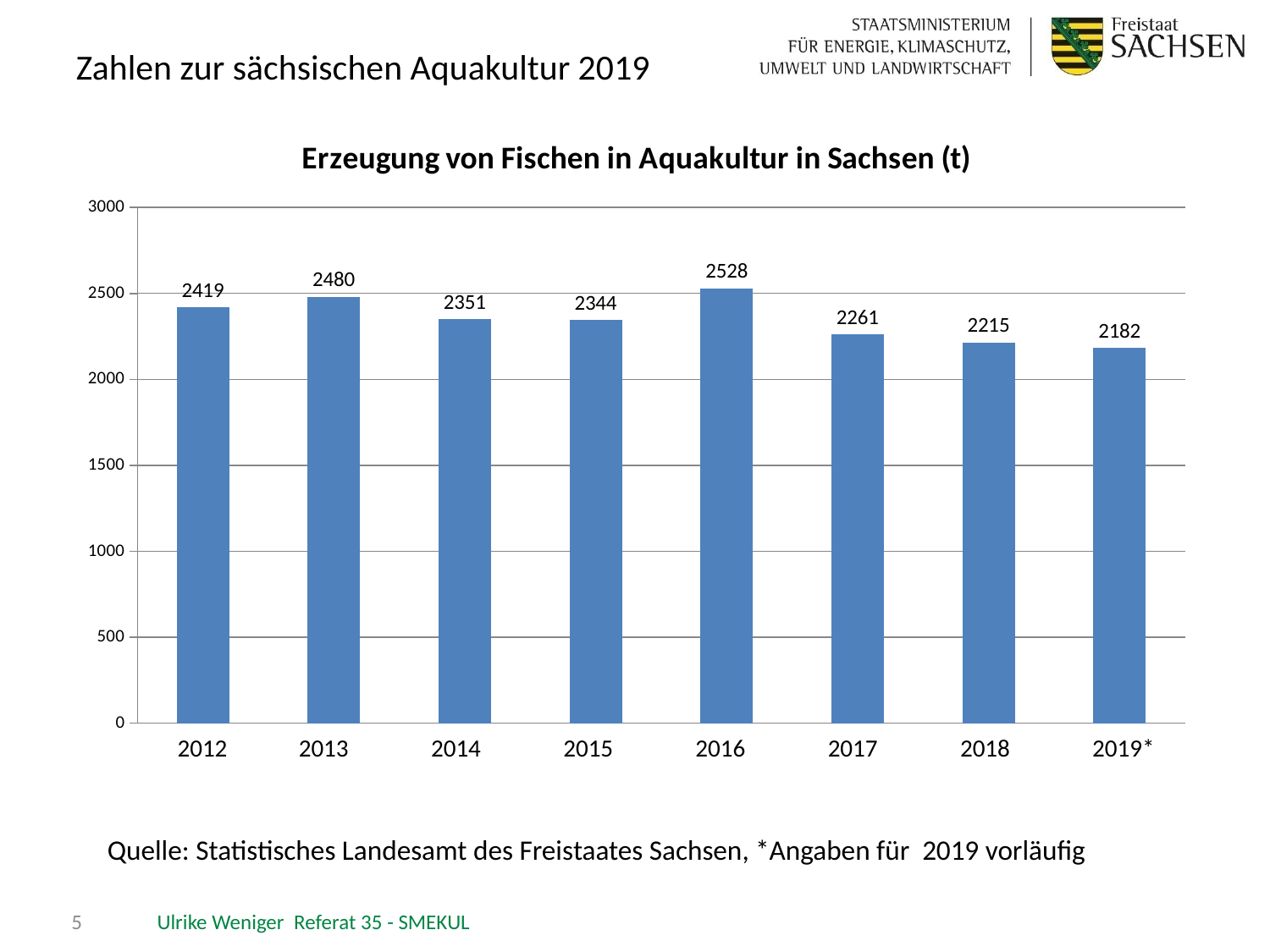
Is the value for 2018 greater or less than 2500? less What is the difference between the values for 2012 and 2013? 61 What is the difference between the values for 2016 and 2019*? 346 Which year has the lowest value? 2019* What kind of chart is shown? bar chart Which is larger, the value for 2014 or the value for 2017? 2014 What is the value for 2013? 2480 What is the value for 2016? 2528 What is the title of the chart? Erzeugung von Fischen in Aquakultur in Sachsen (t) How many years are shown on the x axis? 8 Which year has the highest value? 2016 What is the value for 2019*? 2182